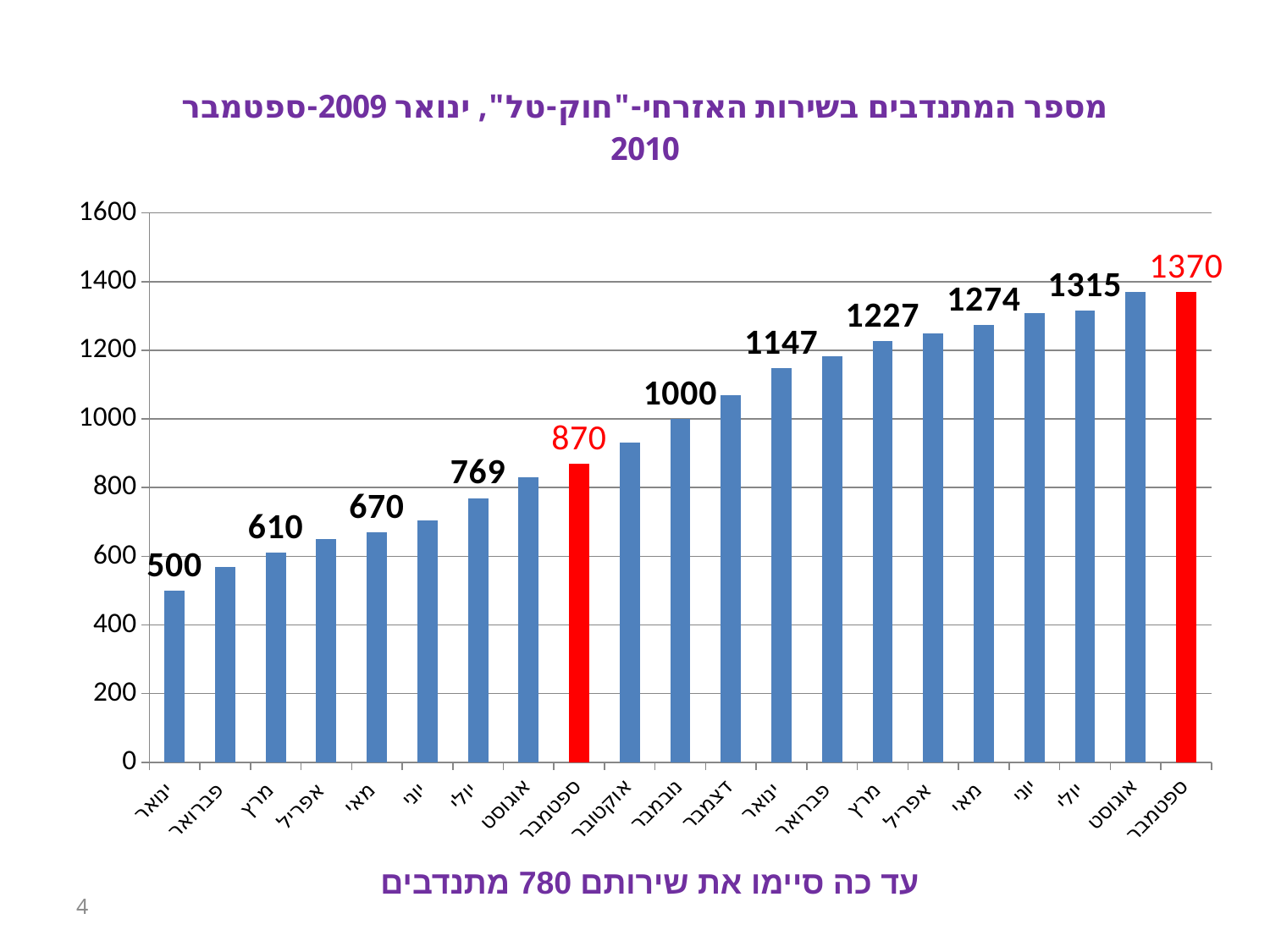
How many bars (months) are shown in the chart? 21 Do the values generally rise or fall from left to right along the x axis? rise Is the value for פברואר 2009 (the second bar) greater or less than 600? less What is the difference between the value for ינואר 2010 (1147) and ינואר 2009 (500)? 647 What is the value of the first red bar (ספטמבר, September 2009)? 870 Which month has the lowest number of volunteers? ינואר 2009 (the first bar) What is the value labelled for נובמבר (November 2009)? 1000 What is the difference between the two red bars (September 2010 and September 2009)? 500 Which is larger, the value for יולי 2009 or the value for מרץ 2010? מרץ 2010 What is the value of the first bar (ינואר, January 2009)? 500 What is the value of the last bar (ספטמבר, September 2010, shown in red)? 1370